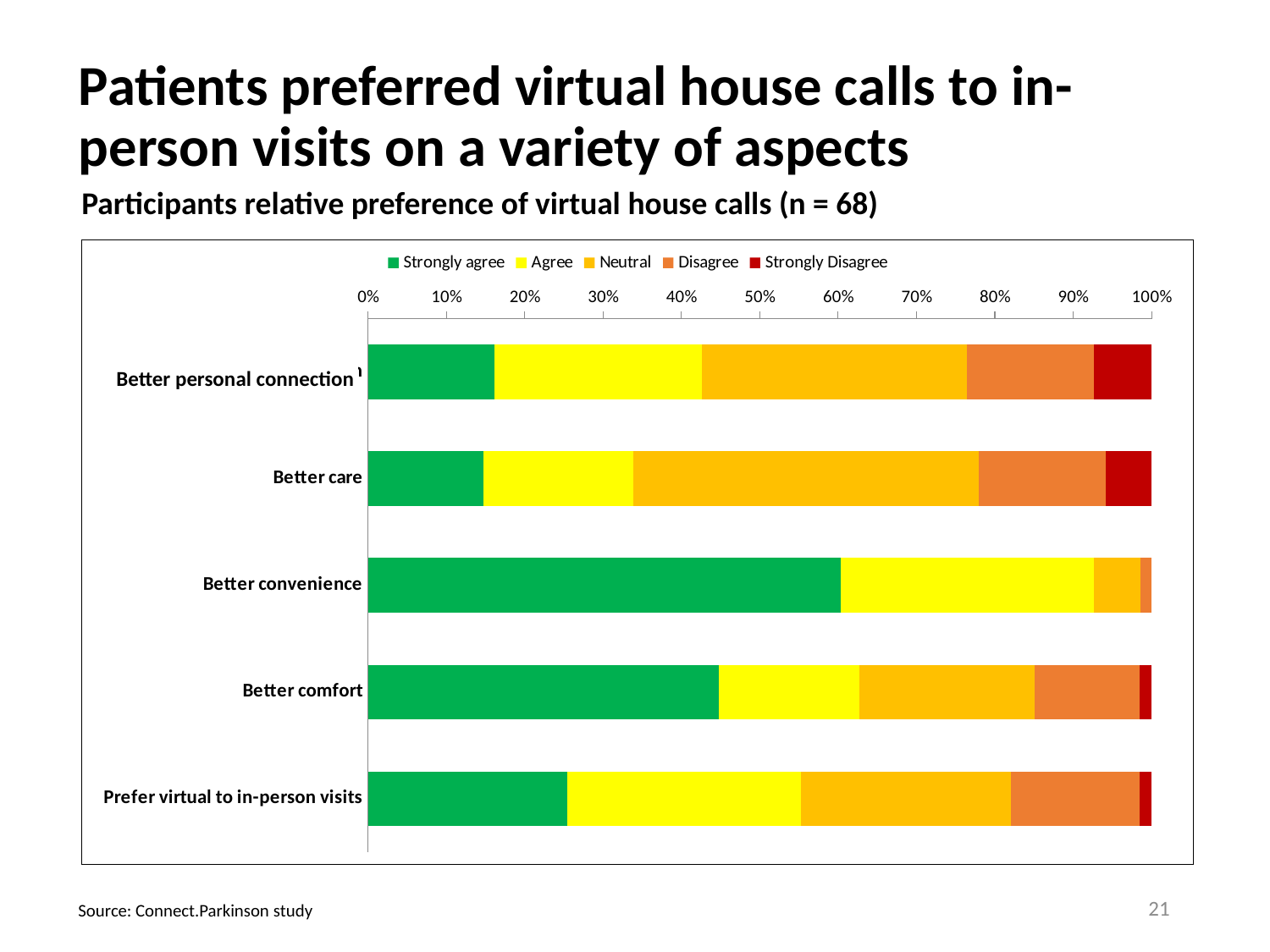
Which category has the smallest Strongly Disagree segment visible, Better convenience or Better care? Better convenience What is the first series listed in the chart legend? Strongly agree Is the Strongly agree value for Prefer virtual to in-person visits greater or less than 20%? greater Is the Strongly agree value for Better personal connection greater or less than 20%? less What kind of chart is shown on the slide? Stacked bar chart Is the Strongly agree value for Better convenience greater or less than 50%? greater Which has a larger Neutral segment: Better care or Better convenience? Better care How many categories (aspects) are plotted on the chart? 5 Which has a larger Strongly agree segment: Better convenience or Better comfort? Better convenience How many series does the chart legend list? 5 Which category has the largest Strongly agree segment? Better convenience